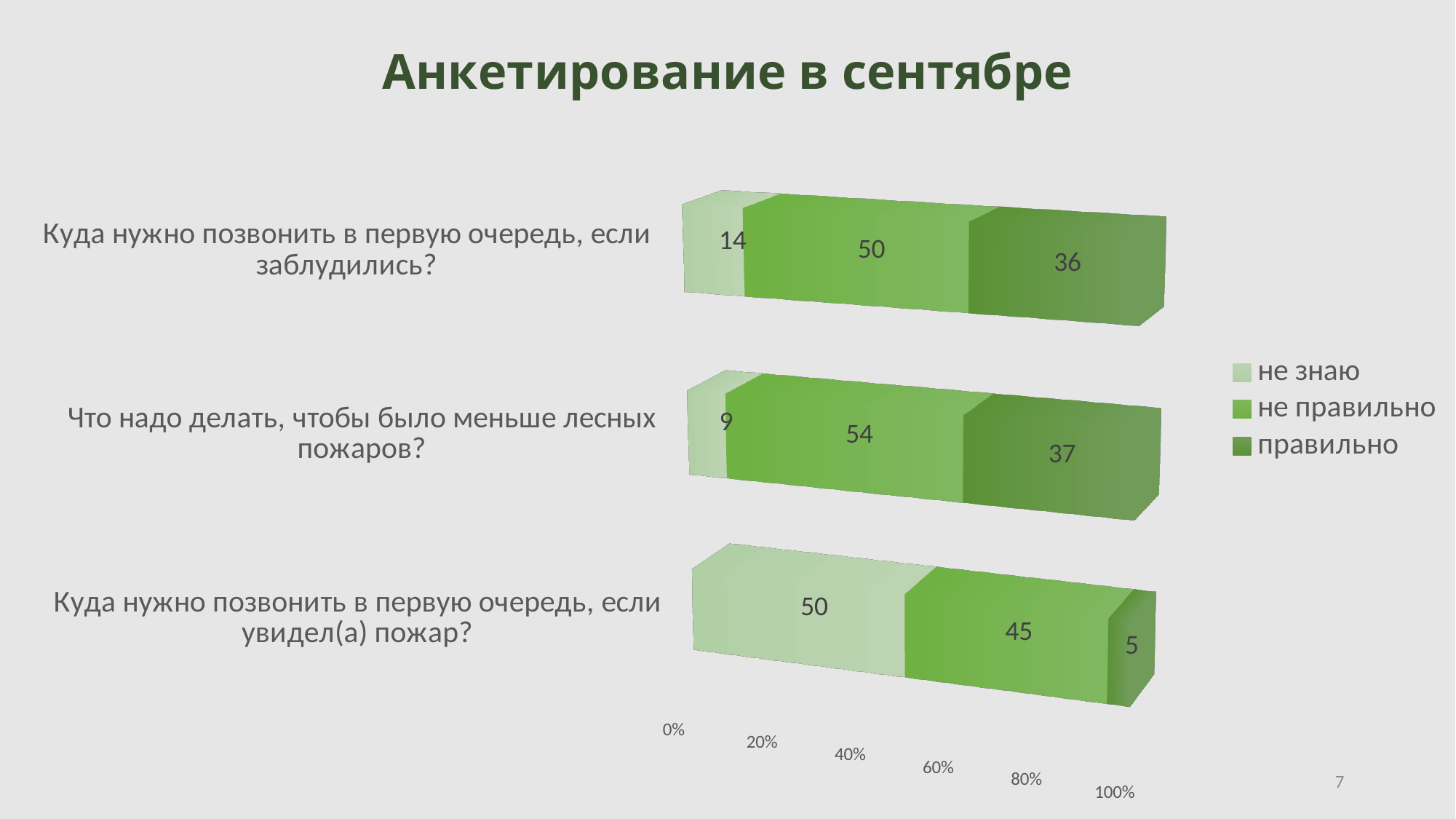
For "Что надо делать, чтобы было меньше лесных пожаров?", which is larger: "не знаю" or "правильно"? правильно What is the total of the stacked bar for "Куда нужно позвонить в первую очередь, если увидел(а) пожар?"? 100 What is the value of "не знаю" for "Куда нужно позвонить в первую очередь, если заблудились?"? 14 What is the title of the chart? Анкетирование в сентябре What is the value of "правильно" for "Что надо делать, чтобы было меньше лесных пожаров?"? 37 How many categories (questions) are shown in the chart? 3 What is the difference between the "не правильно" and "правильно" values for "Куда нужно позвонить в первую очередь, если заблудились?"? 14 What is the value of "не правильно" for "Куда нужно позвонить в первую очередь, если увидел(а) пожар?"? 45 Which category has the highest value for "не знаю"? Куда нужно позвонить в первую очередь, если увидел(а) пожар? Which category has the lowest value for "правильно"? Куда нужно позвонить в первую очередь, если увидел(а) пожар? How many series does the legend list? 3 What kind of chart is shown on the slide? bar chart